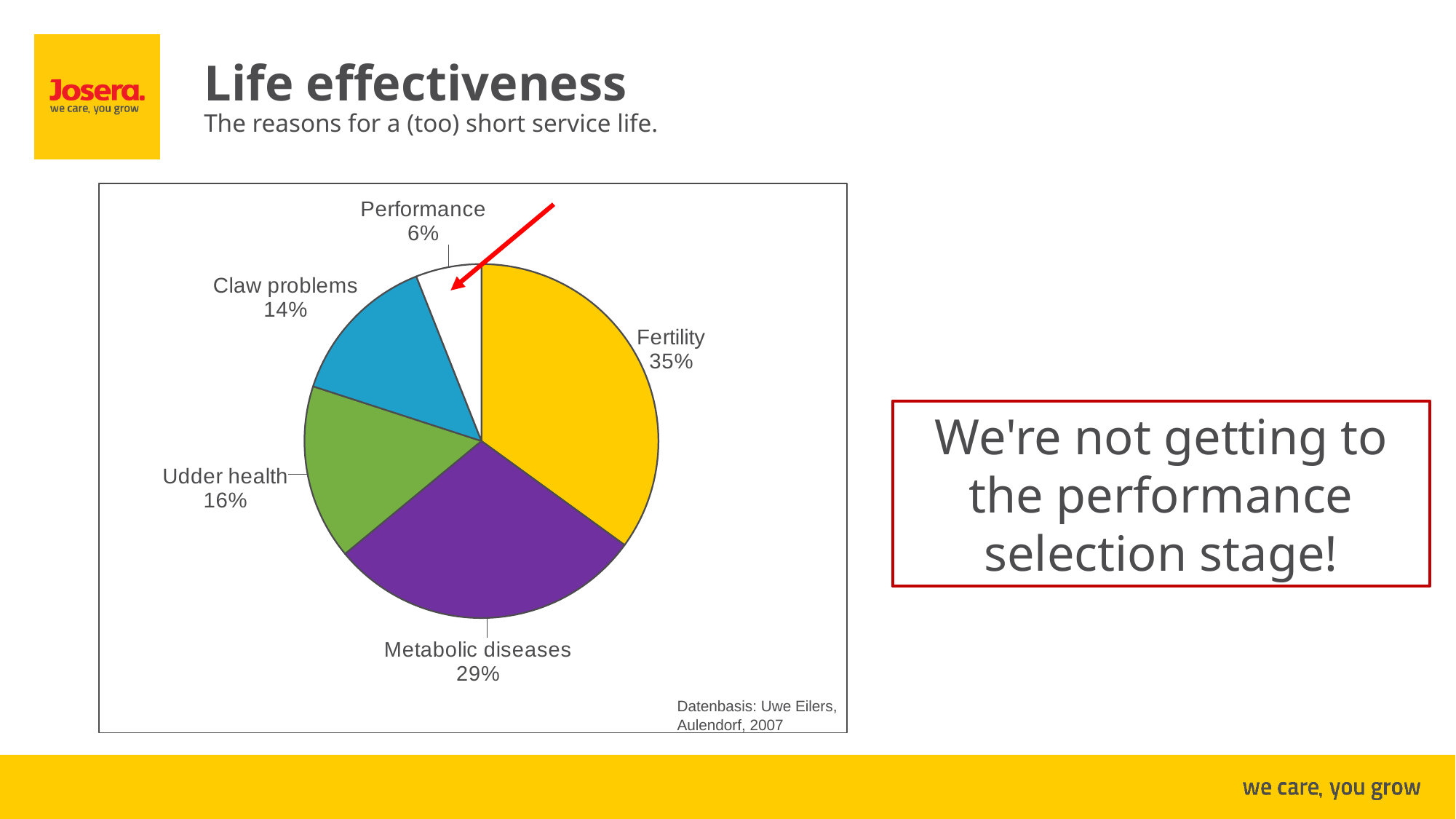
What is the difference between the Fertility and Metabolic diseases shares? 6% How many slices does the pie chart have? 5 Which category has the smallest slice of the pie? Performance What kind of chart is shown on the slide? pie chart What is the value shown for Udder health? 16% Which is larger, the share for Udder health or the share for Claw problems? Udder health Which category has the largest slice of the pie? Fertility What share of the pie does Fertility account for? 35% What colour is the Fertility slice? yellow What is the value shown for Claw problems? 14% What is the value shown for Metabolic diseases? 29% What is the value shown for Performance? 6%